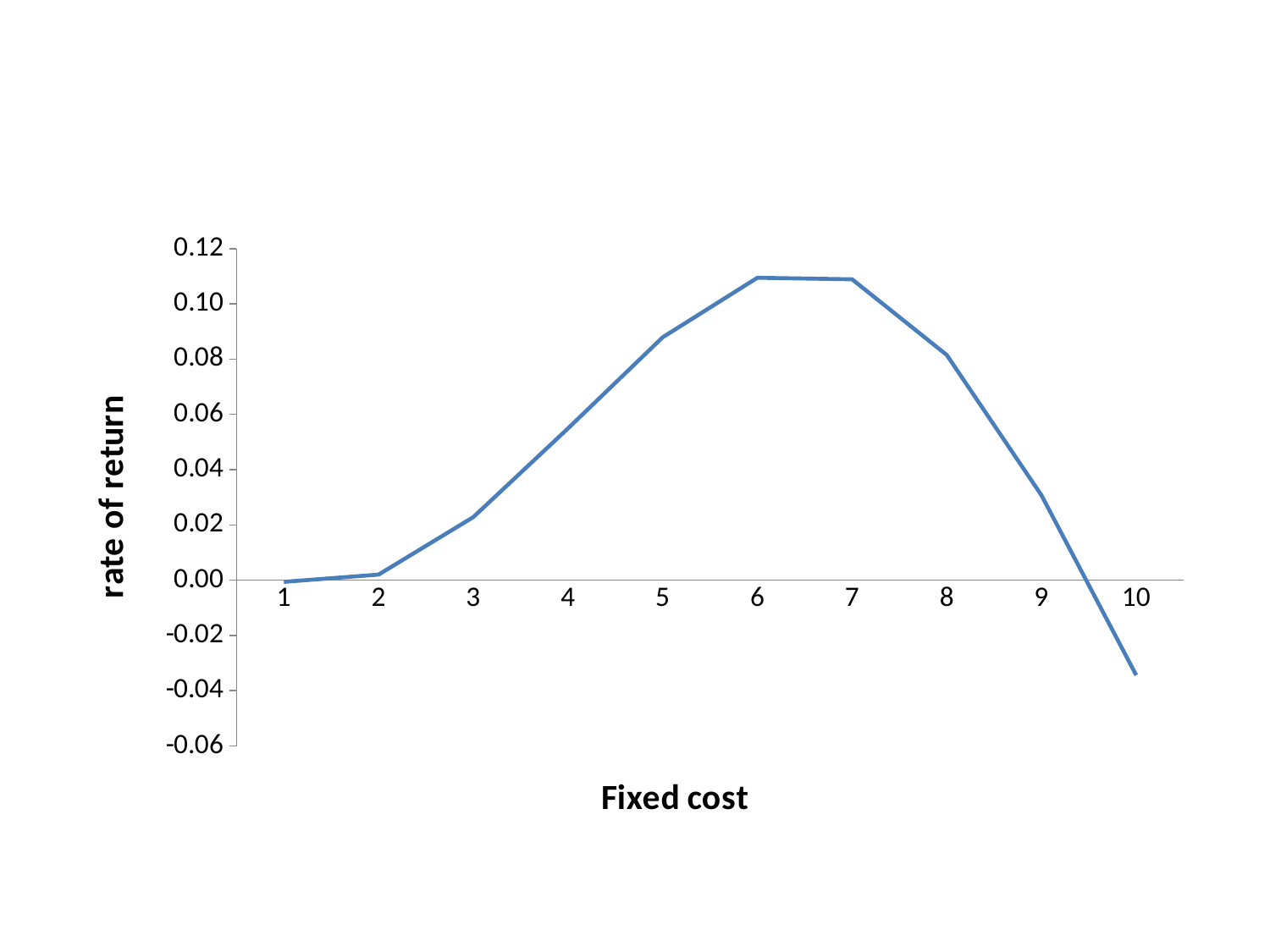
Does the rate of return rise or fall as fixed cost increases from 7 to 10? fall What kind of chart is shown on the slide? line chart How many fixed cost values are plotted along the x axis? 10 Is the rate of return at fixed cost 3 greater or less than 0.04? less Is the rate of return at fixed cost 10 greater or less than 0.00? less Is the rate of return at fixed cost 6 greater or less than 0.10? greater Which has a higher rate of return, fixed cost 3 or fixed cost 5? fixed cost 5 What is the label on the vertical axis? rate of return At which fixed cost is the rate of return lowest? 10 Which has a higher rate of return, fixed cost 8 or fixed cost 9? fixed cost 8